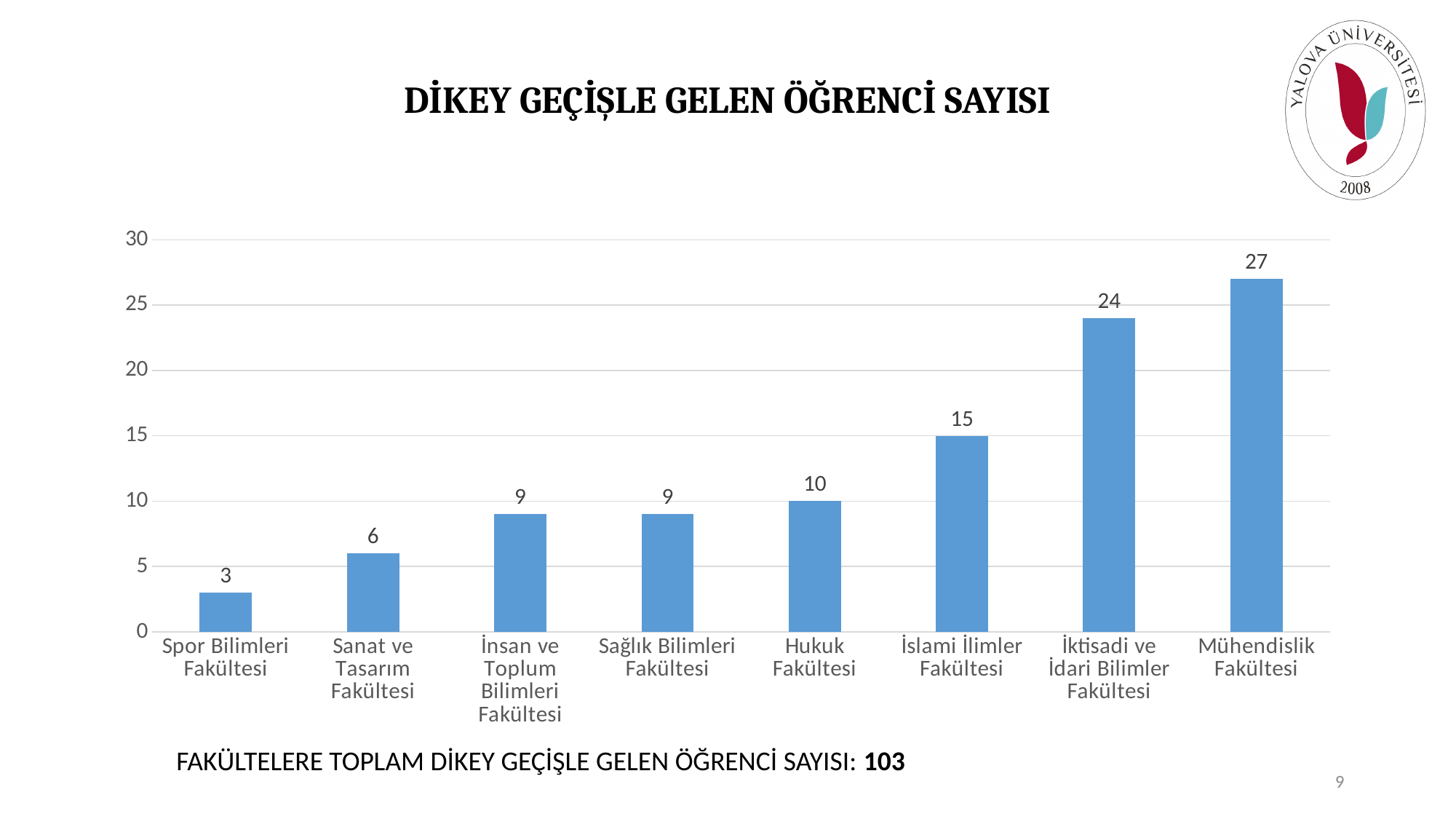
What is the difference between the values for İktisadi ve İdari Bilimler Fakültesi and İslami İlimler Fakültesi? 9 How many faculties are shown on the chart? 8 What kind of chart is shown on the slide? bar chart What is the difference between the values for Mühendislik Fakültesi and Spor Bilimleri Fakültesi? 24 Which faculty has the lowest value? Spor Bilimleri Fakültesi Which is larger, the value for Hukuk Fakültesi or the value for Sağlık Bilimleri Fakültesi? Hukuk Fakültesi Do the values rise or fall from left to right along the x axis? rise What is the value for Hukuk Fakültesi? 10 Which faculty has the highest value? Mühendislik Fakültesi What is the value for Mühendislik Fakültesi? 27 Is the value for İslami İlimler Fakültesi greater or less than 20? less What is the value for Sanat ve Tasarım Fakültesi? 6